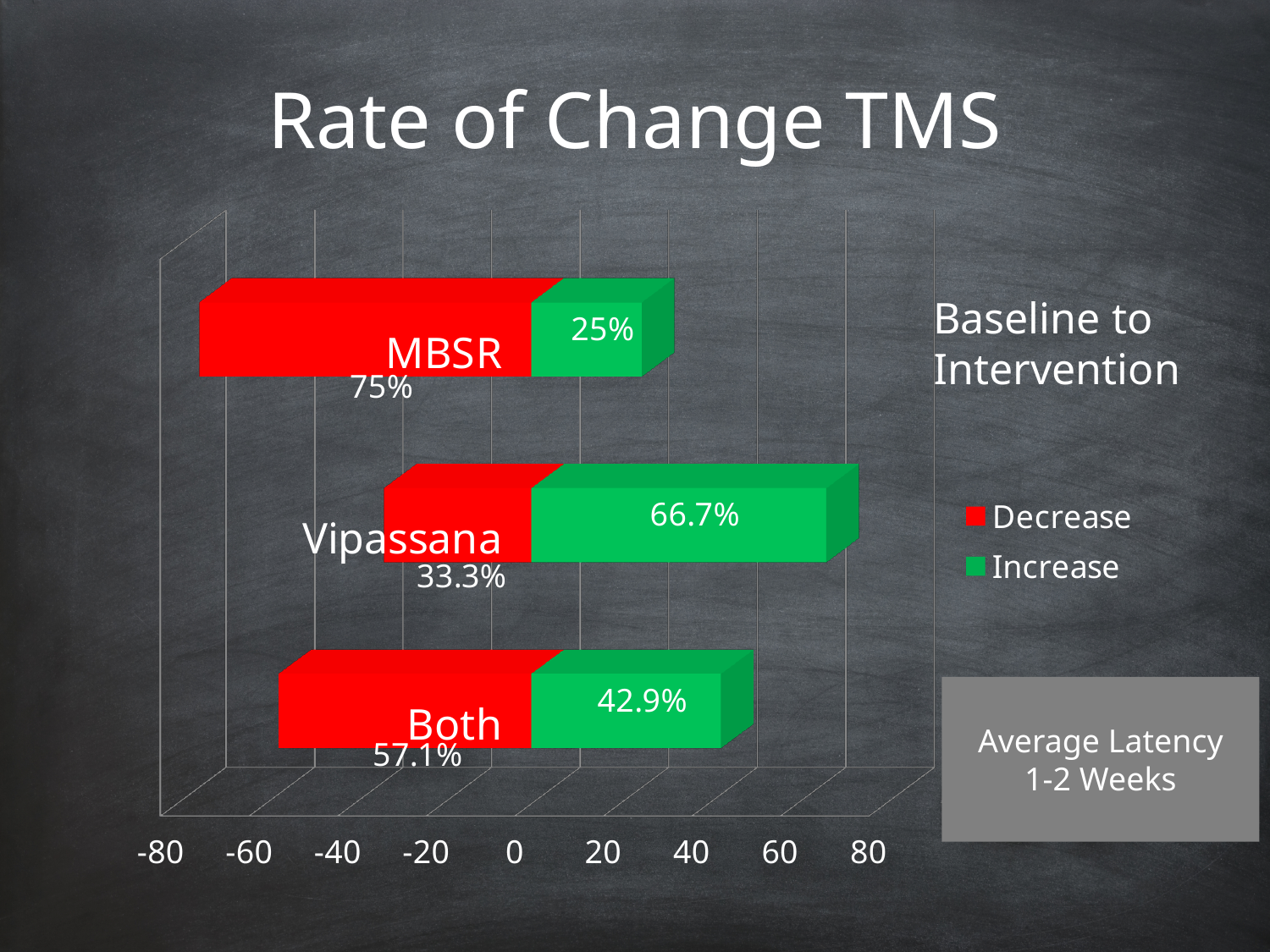
Which colour represents the Increase series in the legend? Green What is the Increase value for Vipassana? 66.7% Which category has the highest Increase value? Vipassana What is the Increase value for Both? 42.9% How many categories are shown on the chart? 3 Which is larger, the Decrease value for Both or the Decrease value for MBSR? MBSR What is the Decrease value for Vipassana? 33.3% How many series does the legend list? 2 Which category has the lowest Decrease value? Vipassana What is the Decrease value for MBSR? 75% What kind of chart is shown on the slide? Bar chart What is the difference between the Increase values for Vipassana and MBSR? 41.7%